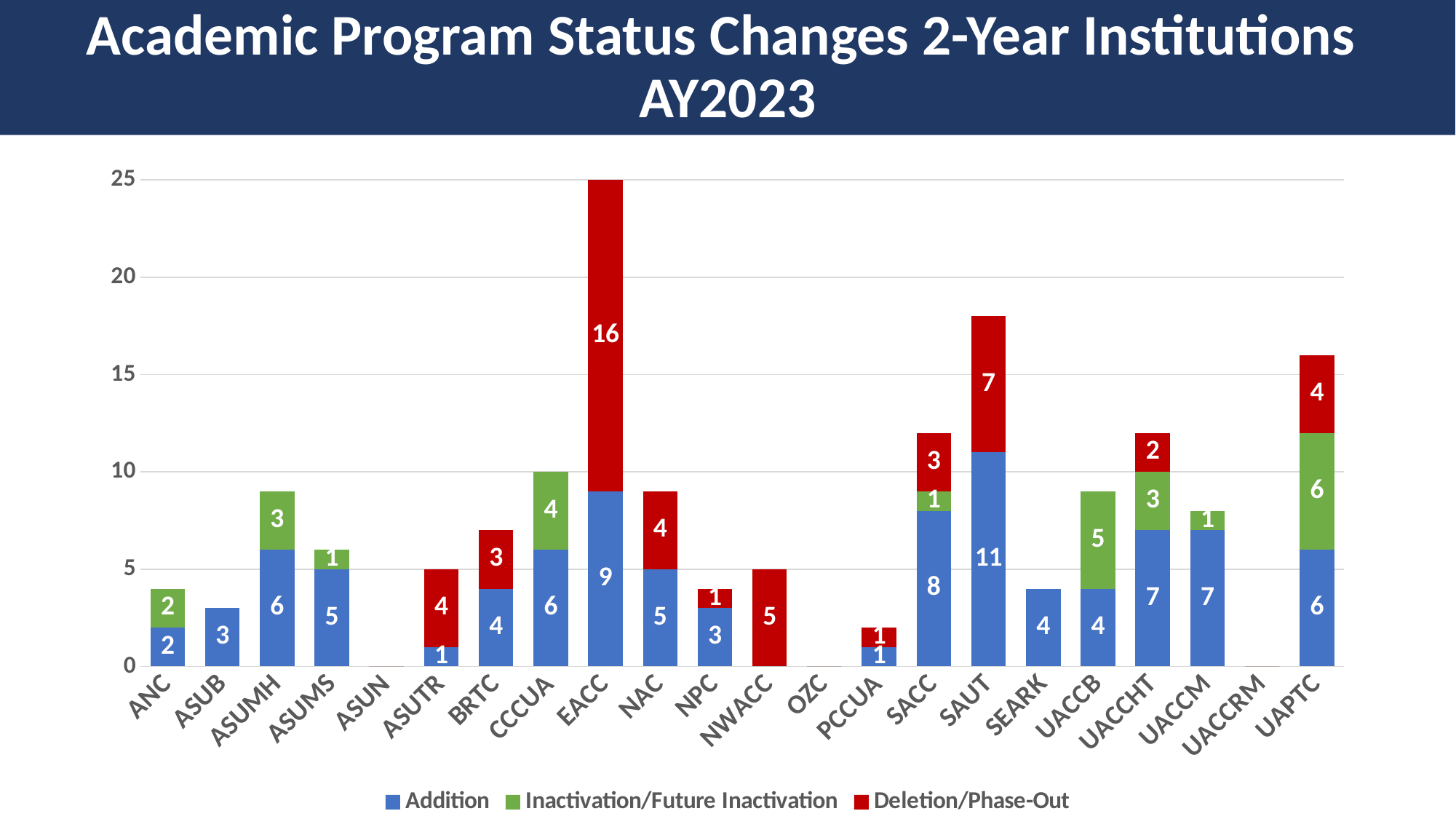
What type of chart is shown on the slide? Stacked bar chart What is the difference between the Deletion/Phase-Out values for EACC and SAUT? 9 What is the total of the stacked bar for SACC? 12 Which institution has the highest total stacked bar? EACC What is the Deletion/Phase-Out value for EACC? 16 What is the total of the stacked bar for UAPTC? 16 What is the Addition value for SAUT? 11 Which is larger, the Addition value for UACCHT or the Addition value for ASUMH? UACCHT How many institutions are listed on the x axis? 22 What is the Inactivation/Future Inactivation value for UACCB? 5 How many series does the legend list? 3 Which colour represents Deletion/Phase-Out in the legend? Red